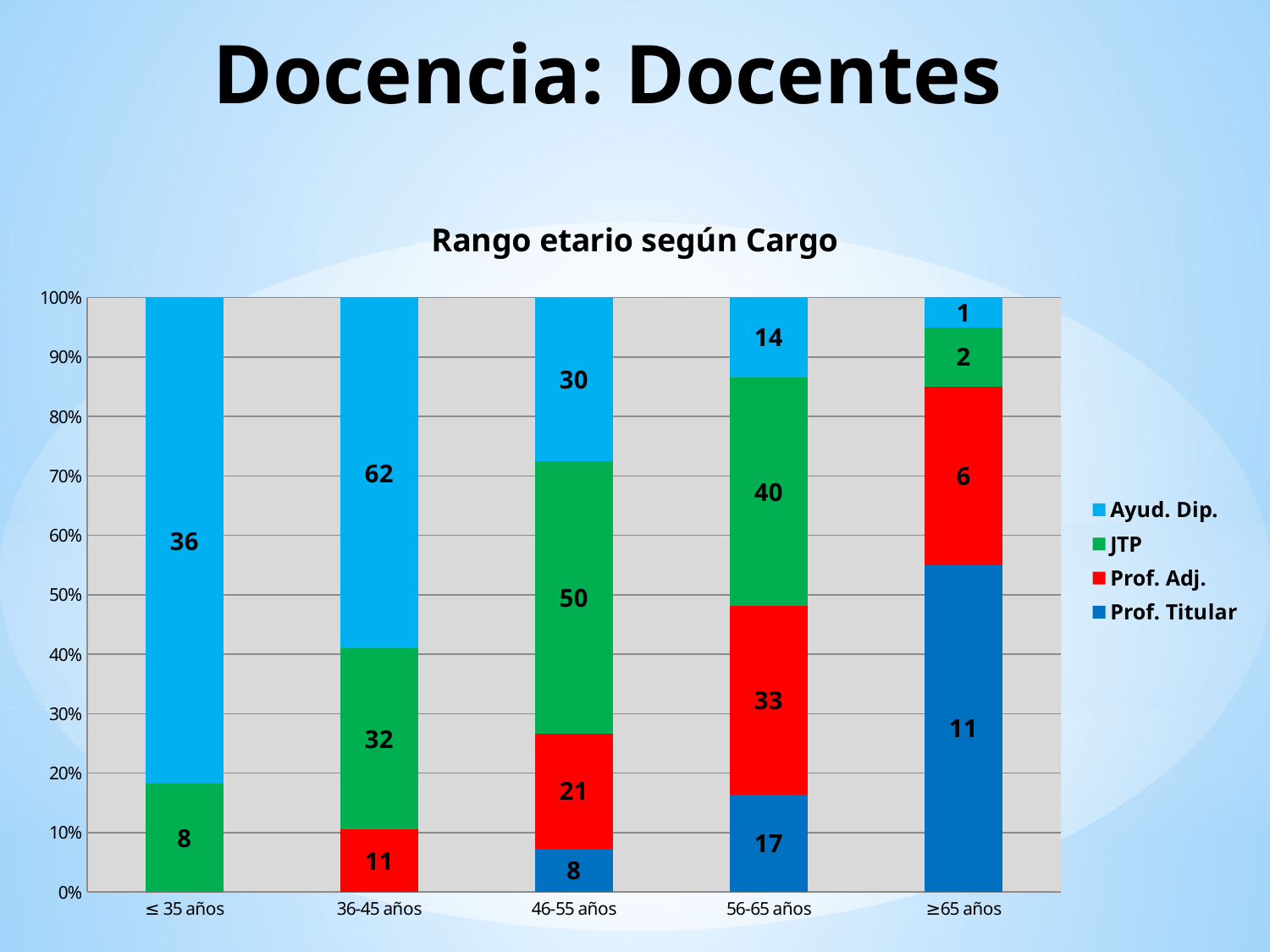
What is the total of the labelled values in the ≥65 años bar? 20 What kind of chart is shown on the slide? Stacked bar chart How many series does the legend list? 4 What is the value for JTP in the 46-55 años category? 50 Which age category has the highest value for Ayud. Dip.? 36-45 años Which age category has the lowest value for JTP? ≥65 años What is the title of the chart? Rango etario según Cargo What is the value for Prof. Titular in the ≥65 años category? 11 What is the difference between the Prof. Adj. values for 56-65 años and 46-55 años? 12 What is the value for Ayud. Dip. in the 36-45 años category? 62 Which is larger: the JTP value for 56-65 años or the Ayud. Dip. value for 46-55 años? JTP for 56-65 años How many age categories are shown on the x axis? 5